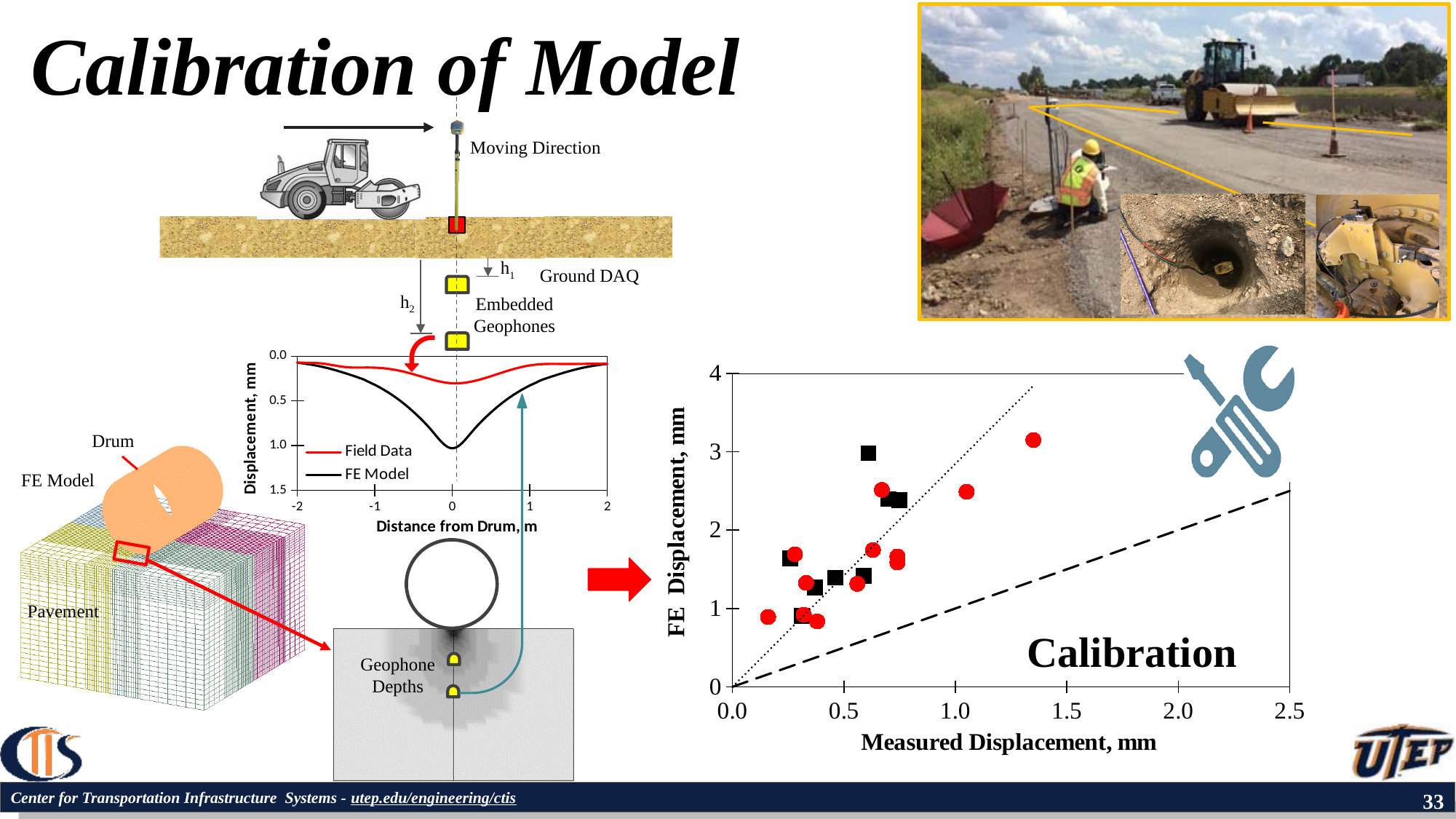
On the 'Distance from Drum, m' line chart, is the FE Model displacement at distance 0 greater or less than 0.5 mm? greater On the 'Distance from Drum, m' line chart, which series reaches the larger displacement at distance 0: Field Data or FE Model? FE Model On the 'Distance from Drum, m' line chart, is the Field Data displacement at distance 0 greater or less than 0.5 mm? less How many series does the legend of the 'Distance from Drum, m' line chart list? 2 What is the x-axis title of the 'Calibration' scatter chart? Measured Displacement, mm What is the y-axis title of the 'Distance from Drum, m' line chart? Displacement, mm What kind of chart is the 'Calibration' chart on the right of the slide? scatter chart What is the maximum value shown on the x axis of the 'Calibration' scatter chart? 2.5 What kind of chart is the 'Distance from Drum, m' chart in the middle of the slide? line chart On the 'Calibration' scatter chart, is the lowest FE Displacement value plotted greater or less than 1 mm? less